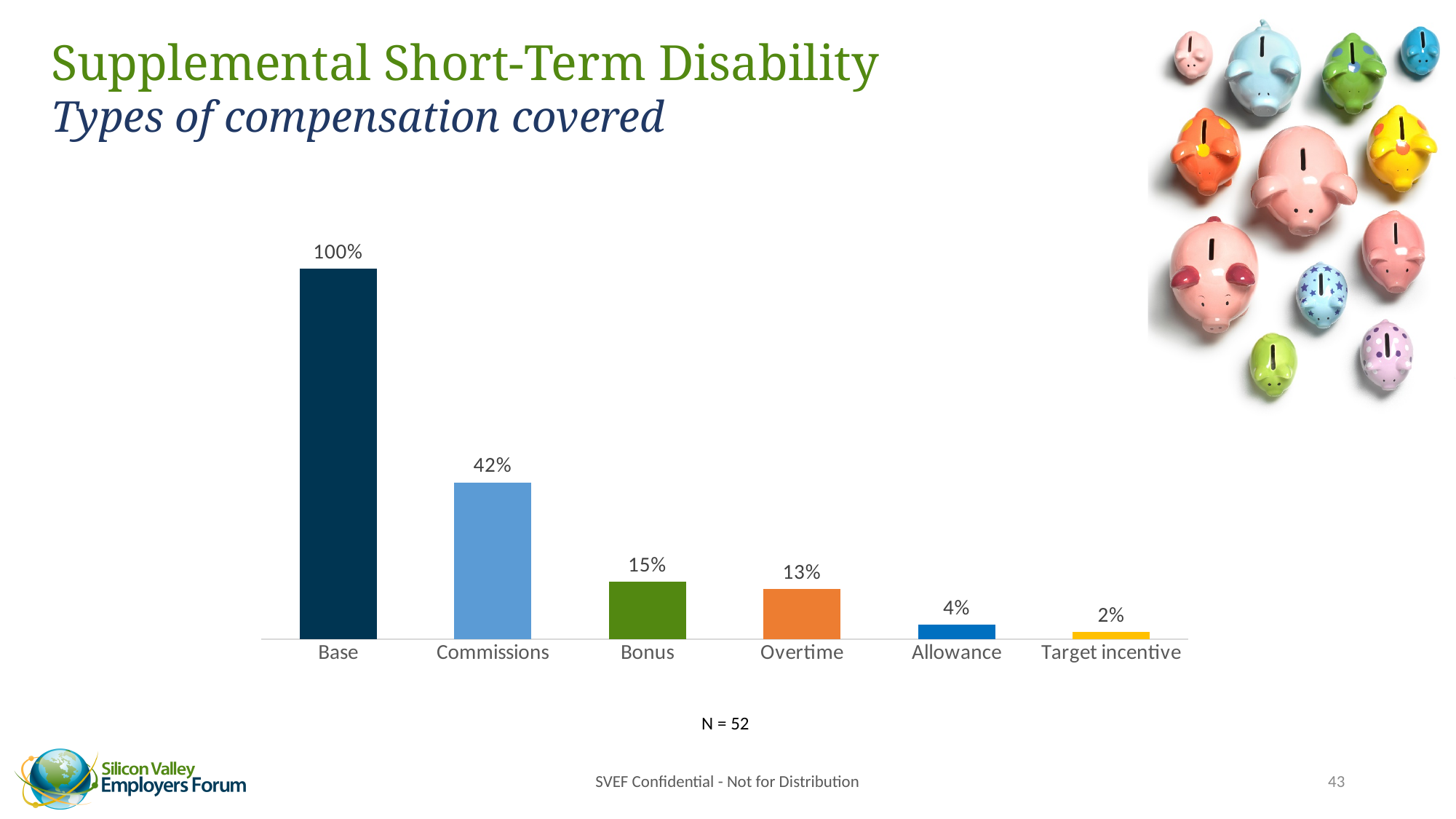
What is the value shown for Commissions? 42% What is the difference between the values for Bonus and Overtime? 2% Which type of compensation has the highest value? Base What is the value shown for Overtime? 13% How many types of compensation are shown on the chart? 6 What kind of chart is shown on the slide? Bar chart What is the difference between the values for Base and Commissions? 58% What percentage of respondents cover Base compensation under supplemental short-term disability? 100% Which type of compensation has the lowest value? Target incentive What is the value shown for Target incentive? 2% Which is larger, the value for Allowance or the value for Target incentive? Allowance What is the sample size (N) noted below the chart? N = 52